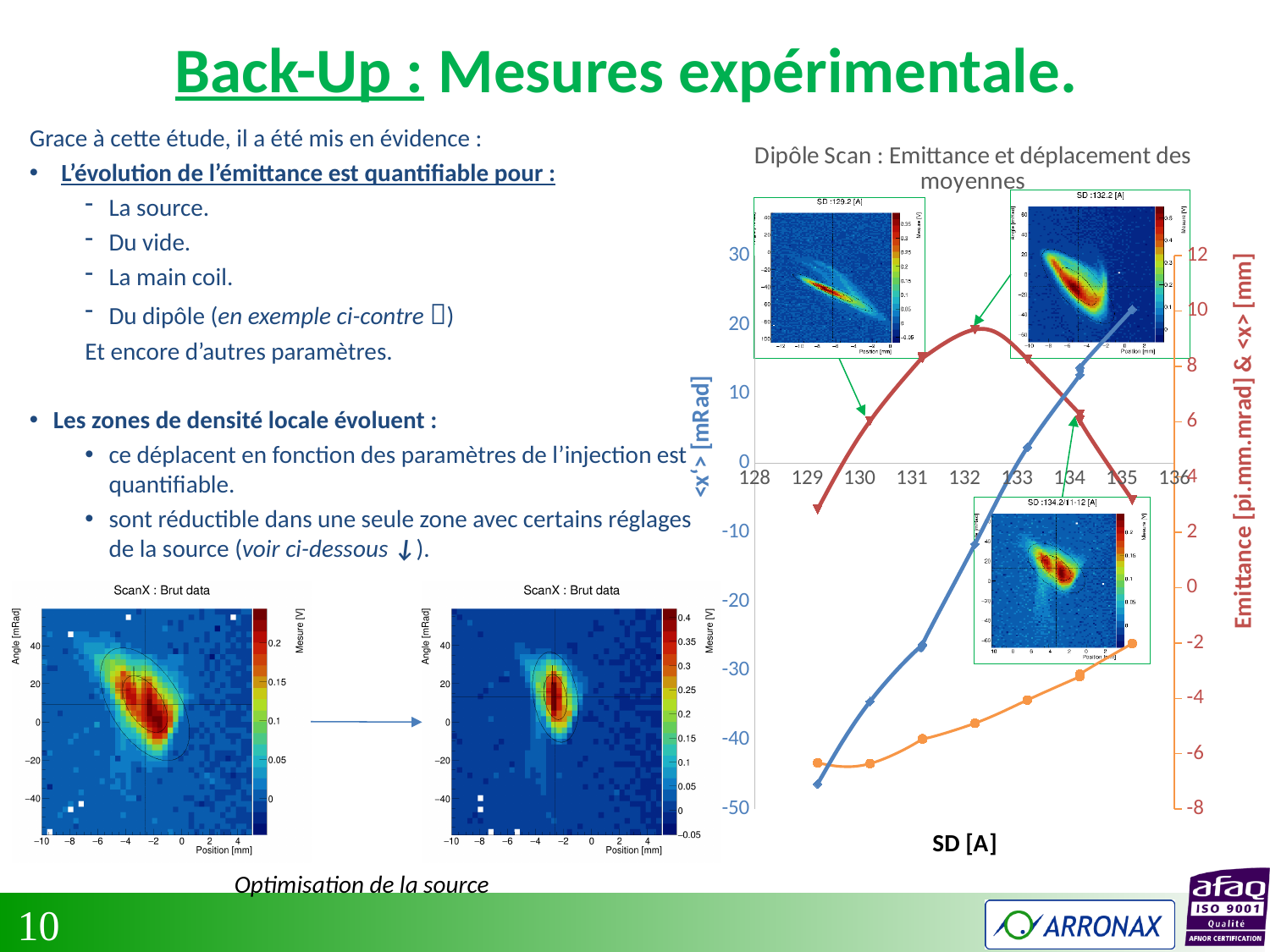
In the 'Dipôle Scan' chart, what is the title of the right-hand y axis? Emittance [pi.mm.mrad] & <x> [mm] In the 'Dipôle Scan' chart, at which SD value does the red series reach its maximum? 132.2 In the 'Dipôle Scan' chart, is the peak value of the red series greater or less than 8 on the right axis? greater What type of chart is 'Dipôle Scan : Emittance et déplacement des moyennes'? line chart In the 'Dipôle Scan' chart, does the blue series rise or fall as SD increases from 129 to 135? rise How many data series are plotted in the 'Dipôle Scan' chart? 3 In the 'Dipôle Scan' chart, is the value of the blue series at SD 129 greater or less than -40 on the left axis? less In the 'Dipôle Scan' chart, does the orange series rise or fall as SD increases from 129 to 135? rise In the 'Dipôle Scan' chart, what is the title of the x axis? SD [A] In the 'Dipôle Scan' chart, is the value of the orange series at SD 135 greater or less than 0 on the right axis? less In the 'Dipôle Scan' chart, at which SD value is the blue series lowest? 129.2 In the 'Dipôle Scan' chart, is the red series higher at SD 132 or at SD 129? SD 132